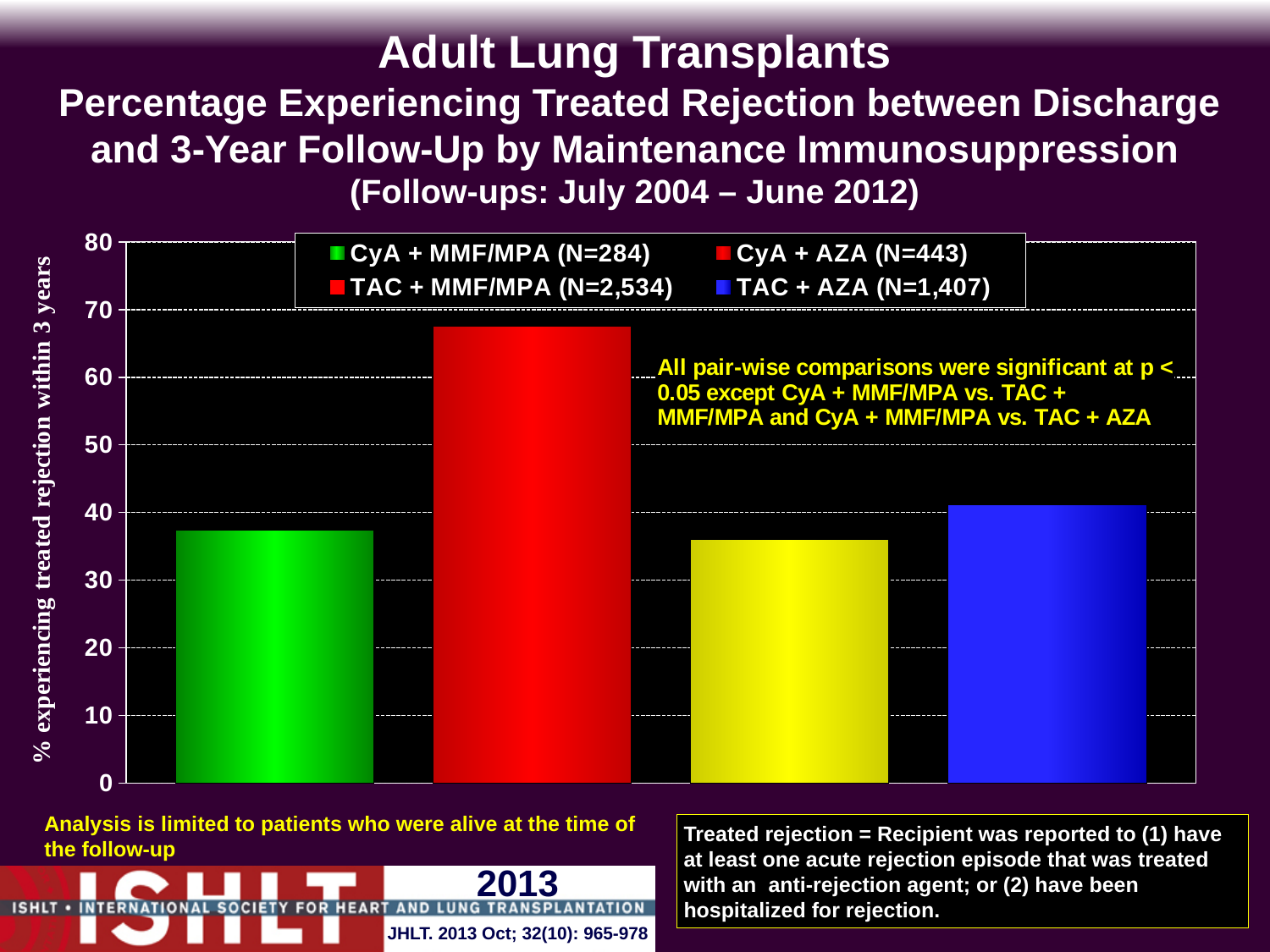
According to the legend, what is the N for the TAC + MMF/MPA group? N=2,534 Which has a higher percentage experiencing treated rejection, TAC + AZA or TAC + MMF/MPA? TAC + AZA Is the value for TAC + MMF/MPA greater or less than 40? less Which maintenance immunosuppression group has the highest percentage experiencing treated rejection within 3 years? CyA + AZA Is the value for TAC + AZA greater or less than 50? less What kind of chart is shown on the slide? bar chart What is the maximum value shown on the y axis of the chart? 80 How many bars are plotted in the chart? 4 Which has a higher percentage experiencing treated rejection, CyA + AZA or TAC + AZA? CyA + AZA Is the value for CyA + MMF/MPA greater or less than 40? less How many series does the legend list? 4